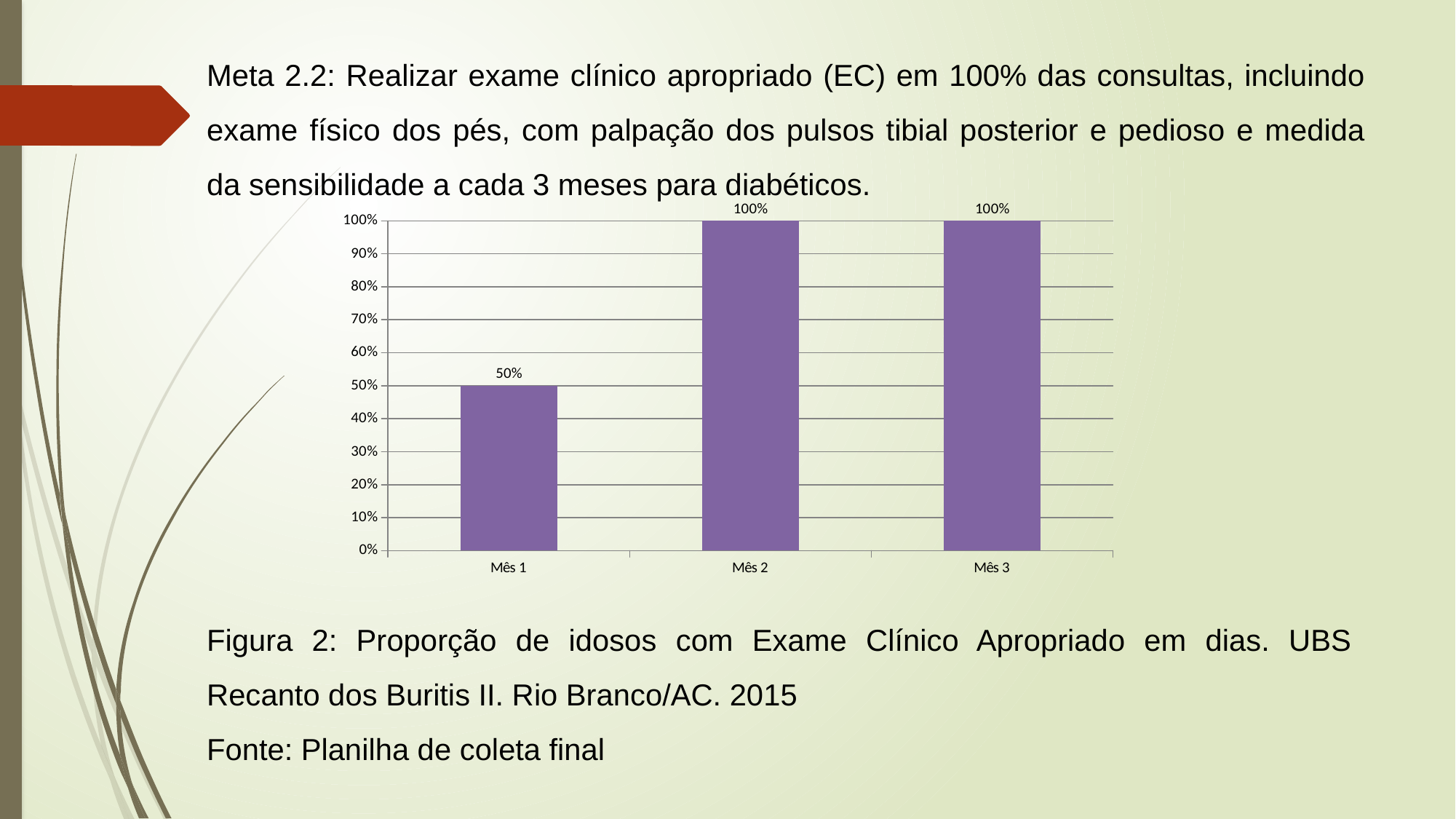
What is the difference between the values for Mês 2 and Mês 1? 50% Is the value for Mês 1 greater or less than 60%? less What is the value for Mês 1? 50% What kind of chart is shown on the slide? bar chart How many months are shown on the x axis? 3 Which month has the lowest value? Mês 1 Which is larger, the value for Mês 1 or the value for Mês 3? Mês 3 What is the value for Mês 3? 100% What colour are the bars in the chart? purple What is the value for Mês 2? 100% Do the values rise or fall from Mês 1 to Mês 2? rise What is the highest value shown on the y axis? 100%